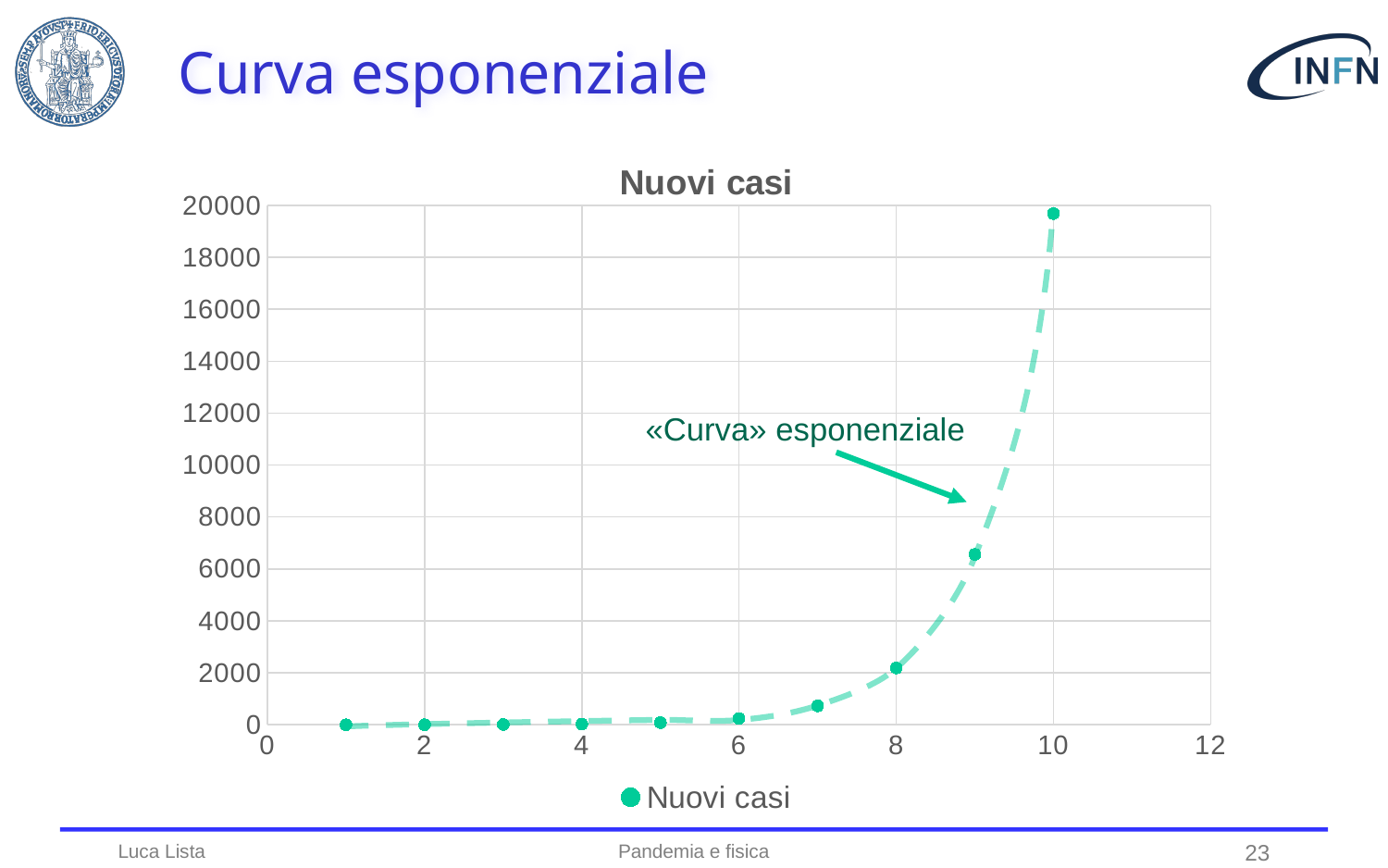
At which x value is the number of new cases highest? 10 Is the value at x = 9 greater or less than 8000? less Is the value at x = 9 greater or less than 6000? greater Is the value at x = 10 greater or less than 18000? greater What kind of chart is shown on the slide? line chart Do the values rise or fall as x increases from 1 to 10? rise Which has the larger value, x = 8 or x = 9? 9 What text does the annotation with the arrow inside the chart say? «Curva» esponenziale How many series does the legend list? 1 How many data points are plotted in the chart? 10 What is the title of the chart? Nuovi casi